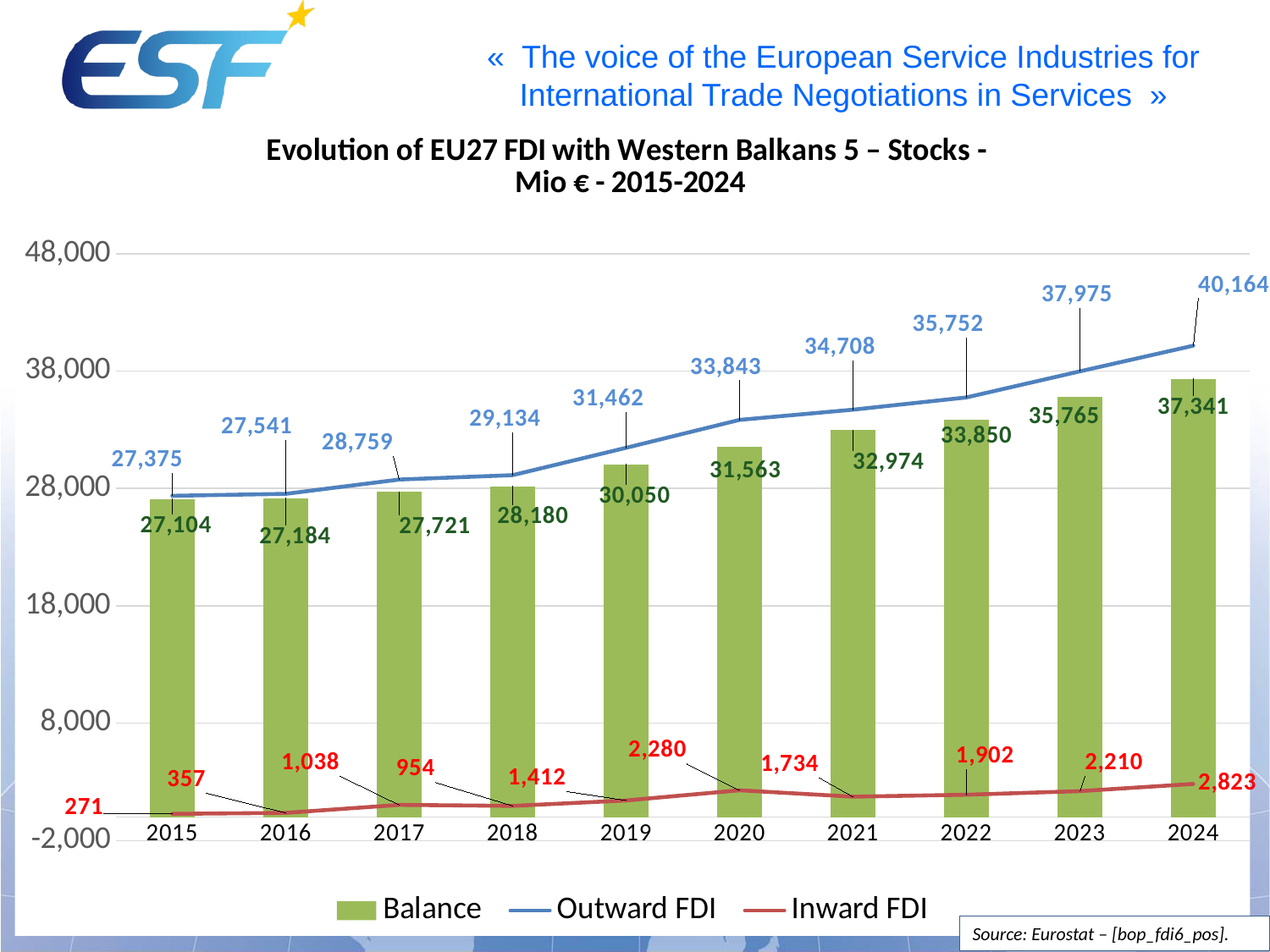
In which year is Inward FDI lowest? 2015 What is the difference between Outward FDI in 2024 and Outward FDI in 2015? 12,789 What is the Balance value for 2019? 30,050 Does Outward FDI rise or fall from 2015 to 2024? rise What is the Outward FDI value for 2024? 40,164 How many years are shown on the x axis? 10 What is the Inward FDI value for 2017? 1,038 Which is larger, Inward FDI in 2020 or Inward FDI in 2021? Inward FDI in 2020 Which series is shown as green bars? Balance Is the Balance value for 2022 greater or less than 28,000? greater How many series does the legend list? 3 In which year is the Balance highest? 2024